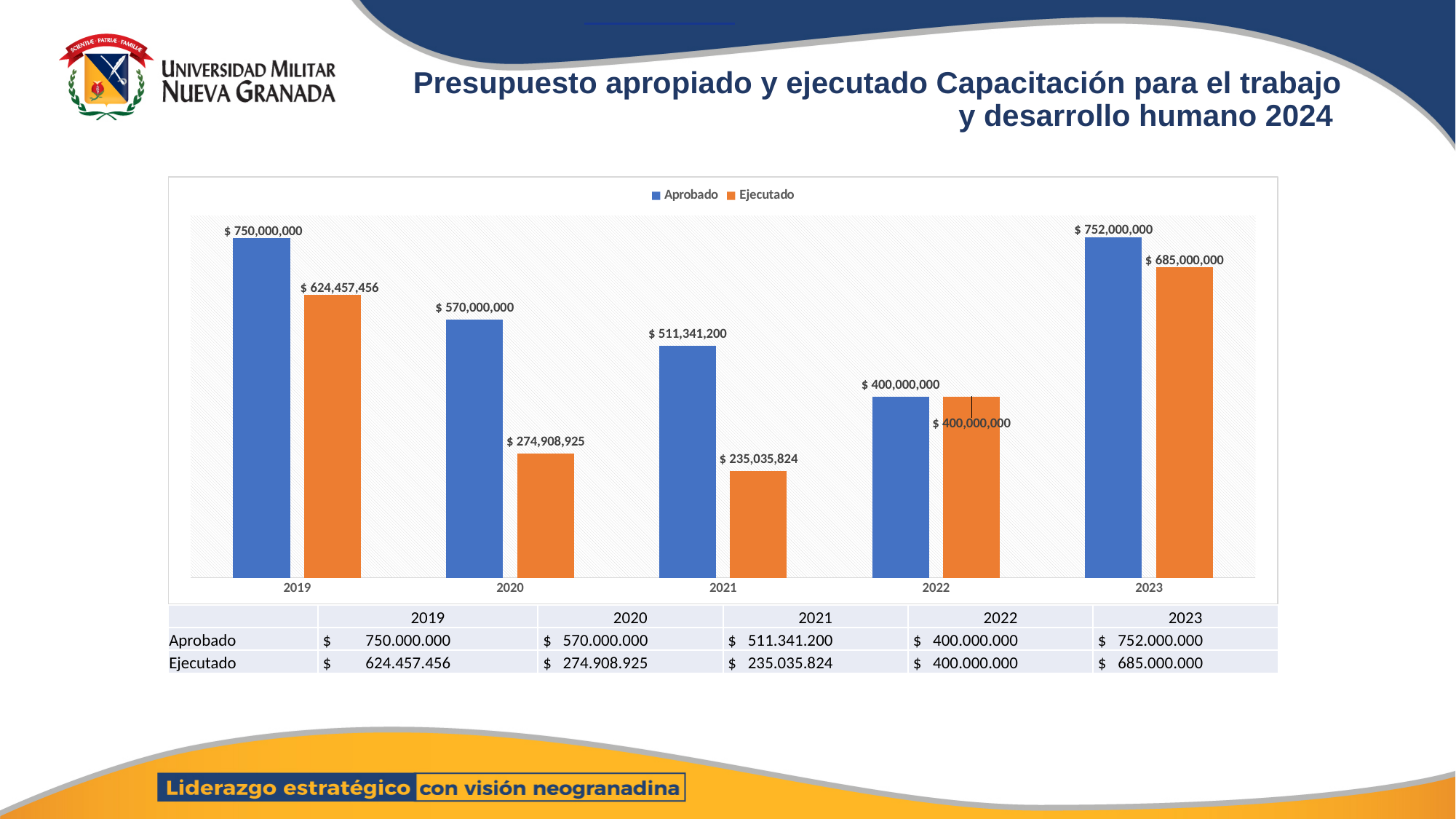
What is the difference between the Aprobado and Ejecutado values for 2019? $ 125,542,544 What is the Aprobado value for 2019? $ 750,000,000 What is the Aprobado value for 2023? $ 752,000,000 Which year has the lowest Aprobado value? 2022 How many series does the legend list? 2 Which year has the highest Ejecutado value? 2023 What is the Ejecutado value for 2021? $ 235,035,824 What is the difference between the Aprobado and Ejecutado values for 2023? $ 67,000,000 What is the Ejecutado value for 2020? $ 274,908,925 Which is larger, the Ejecutado value for 2019 or the Ejecutado value for 2022? Ejecutado 2019 Which year has the lowest Ejecutado value? 2021 What kind of chart is shown on the slide? Bar chart